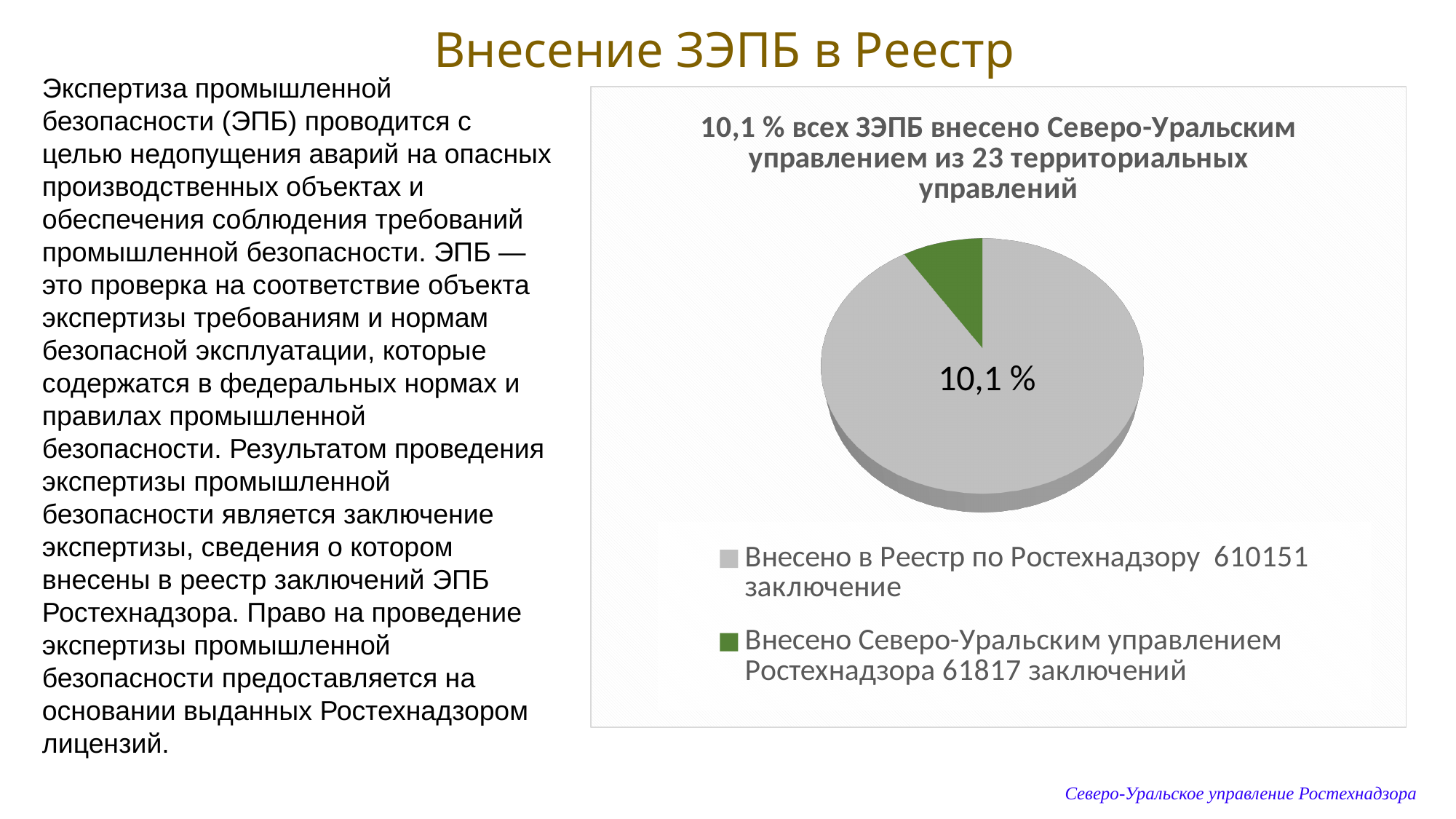
What is the title of the pie chart? 10,1 % всех ЗЭПБ внесено Северо-Уральским управлением из 23 территориальных управлений How many slices does the pie chart have? 2 How many entries does the legend of the pie chart list? 2 What colour is the slice for 'Внесено Северо-Уральским управлением Ростехнадзора'? green Which slice of the pie chart is the largest? Внесено в Реестр по Ростехнадзору What kind of chart is shown on the slide? pie chart What share of the pie is labelled for the slice 'Внесено Северо-Уральским управлением Ростехнадзора'? 10,1 % According to the legend, how many заключений were entered by Северо-Уральское управление Ростехнадзора? 61817 According to the legend, how many заключений were entered into the Реестр по Ростехнадзору? 610151 Which slice of the pie chart is the smallest? Внесено Северо-Уральским управлением Ростехнадзора Which slice of the pie chart is larger: 'Внесено в Реестр по Ростехнадзору' or 'Внесено Северо-Уральским управлением Ростехнадзора'? Внесено в Реестр по Ростехнадзору